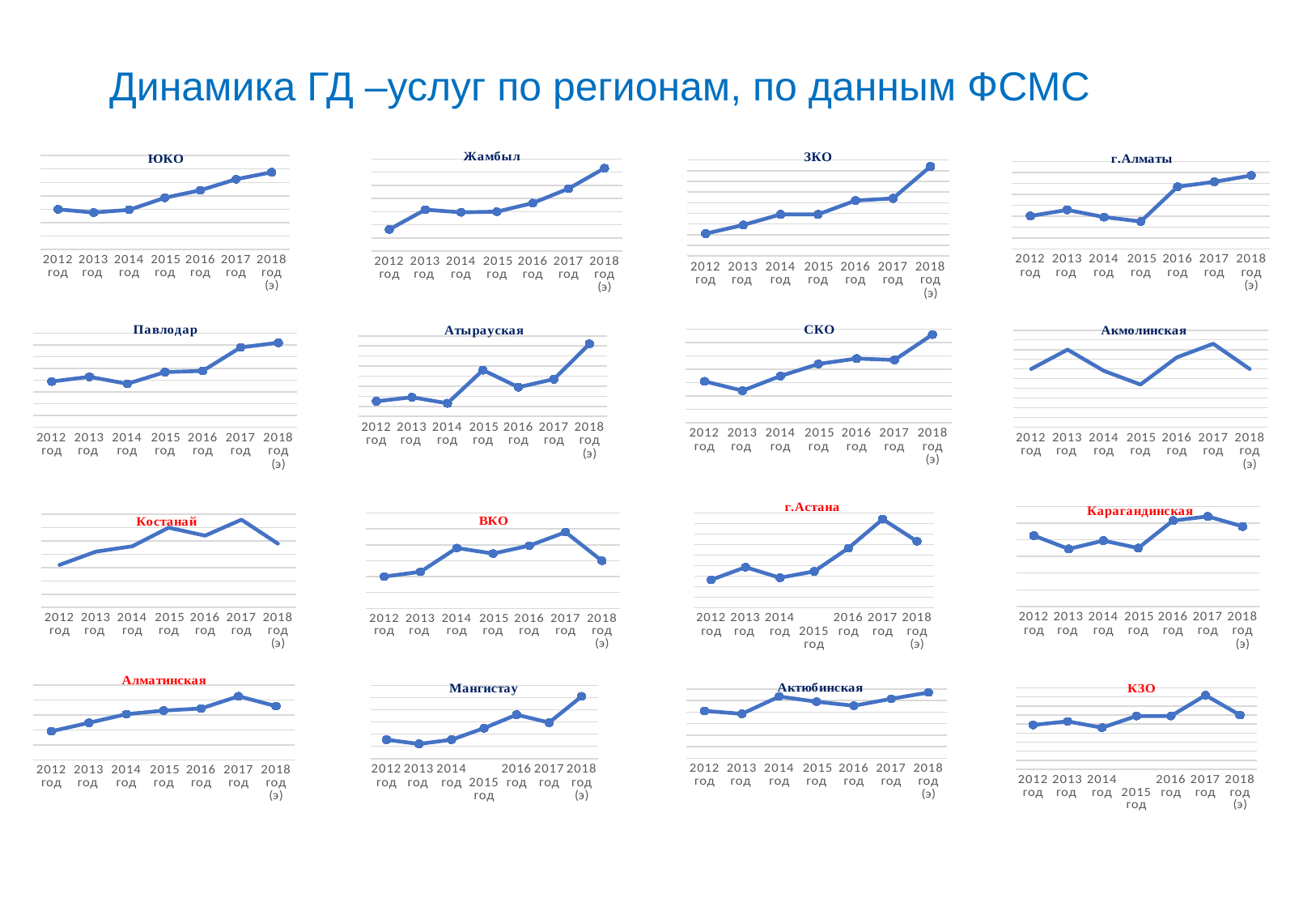
In the ЗКО chart, which year has the highest value? 2018 год (э) How many data points does the Жамбыл chart plot? 7 In the Акмолинская chart, which year has the lowest value? 2015 год What is the title of the slide? Динамика ГД –услуг по регионам, по данным ФСМС In the г.Алматы chart, which year has the lowest value? 2015 год In the Костанай chart, which year has the highest value? 2017 год In the ЮКО chart, do the values rise or fall from 2015 to 2018? rise In the Акмолинская chart, which year has the highest value? 2017 год In the г.Астана chart, which is larger, the value for 2017 or for 2018? 2017 год In the ВКО chart, which is larger, the value for 2017 or for 2018? 2017 год How many charts are shown on the slide? 16 What kind of chart is the ЮКО chart? line chart